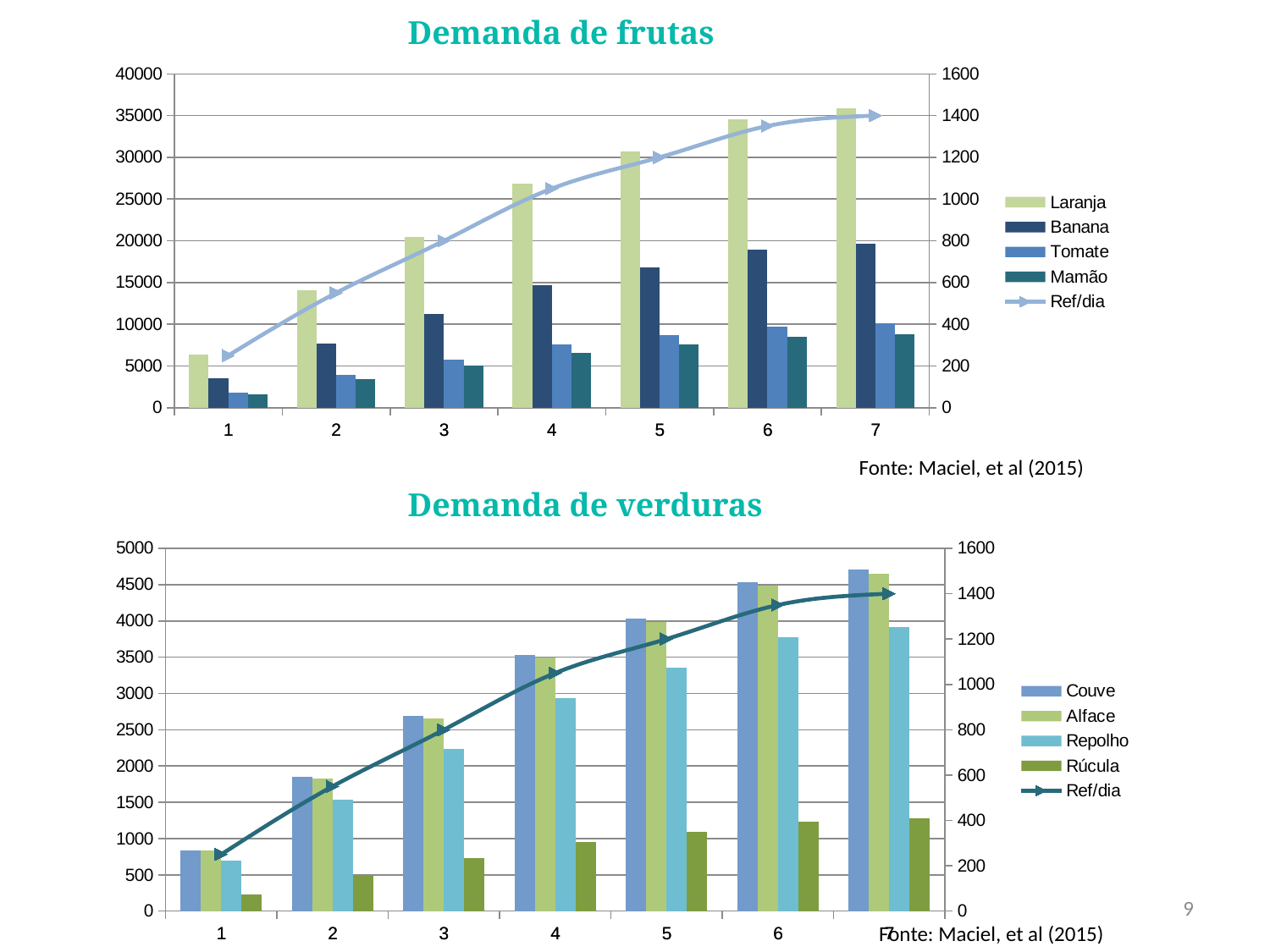
In the 'Demanda de frutas' chart, how many series does the legend list? 5 In the 'Demanda de verduras' chart, how many series does the legend list? 5 In the 'Demanda de frutas' chart, is the value for Laranja at category 4 greater or less than 25000? greater In the 'Demanda de frutas' chart, how many categories are shown on the x axis? 7 In the 'Demanda de frutas' chart, which is larger at category 3: Banana or Tomate? Banana In the 'Demanda de verduras' chart, which series has the lowest bar at category 1? Rúcula In the 'Demanda de frutas' chart, which series has the tallest bar at category 7? Laranja In the 'Demanda de verduras' chart, is the value for Rúcula at category 1 greater or less than 500? less In the 'Demanda de frutas' chart, is the value for Banana at category 6 greater or less than 20000? less What is the title of the top chart on the slide? Demanda de frutas In the 'Demanda de frutas' chart, does the Ref/dia line rise or fall from category 1 to category 7? rise